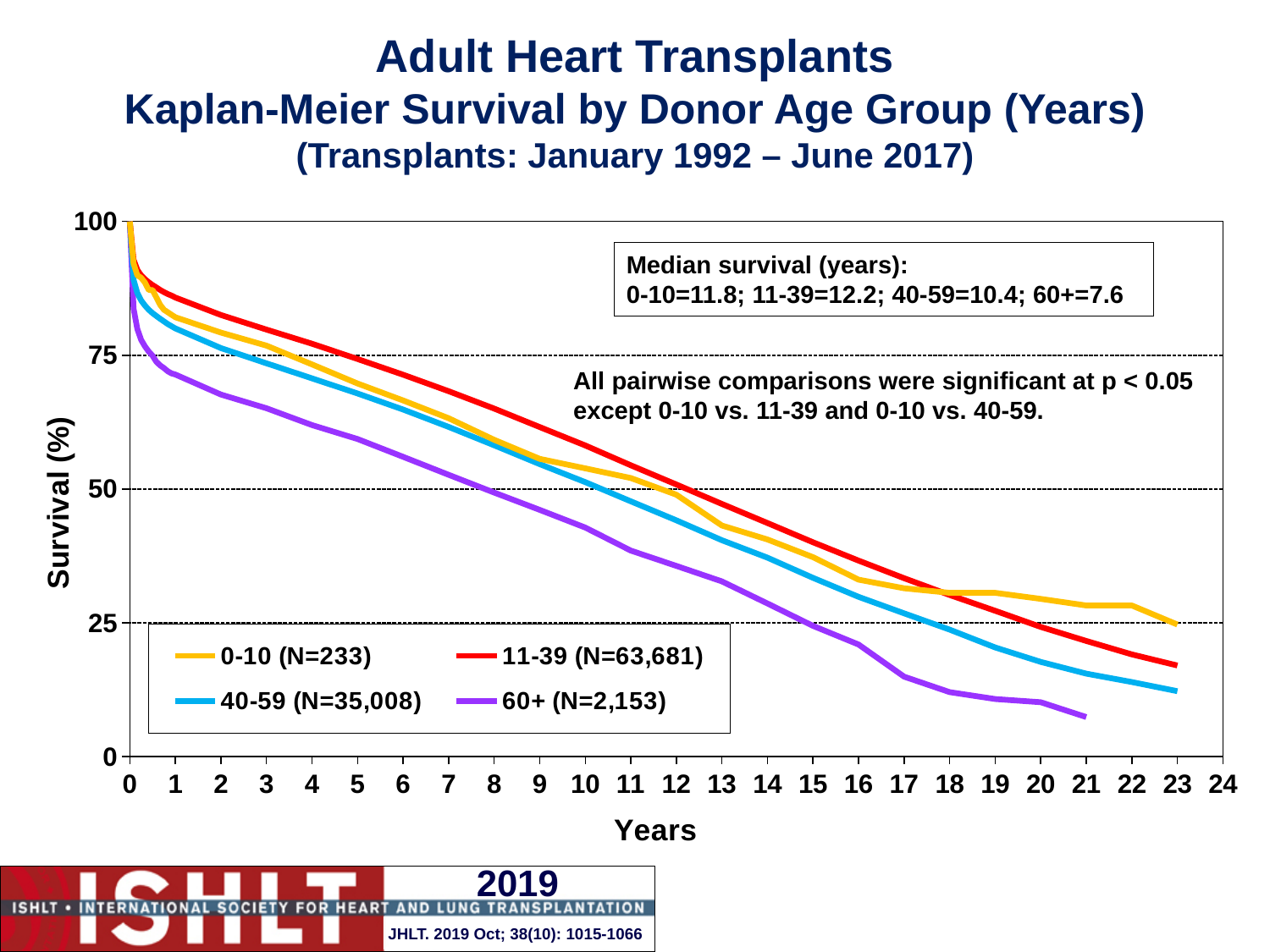
What is the median survival in years for the 60+ donor age group? 7.6 Which donor age group has the highest median survival? 11-39 Is the survival value for the 60+ group at 10 years greater or less than 50? less What kind of chart is shown on the slide? line chart Which donor age group has the lowest median survival? 60+ Is the survival value for the 11-39 group at 15 years greater or less than 50? less What is the N (number of transplants) shown in the legend for the 11-39 donor age group? 63,681 Which has the larger median survival, the 0-10 group or the 40-59 group? 0-10 What is the median survival in years for the 11-39 donor age group? 12.2 Which donor age group has the lowest survival curve at 20 years? 60+ What is the difference in median survival (years) between the 11-39 and 60+ donor age groups? 4.6 How many donor age groups (series) does the legend list? 4